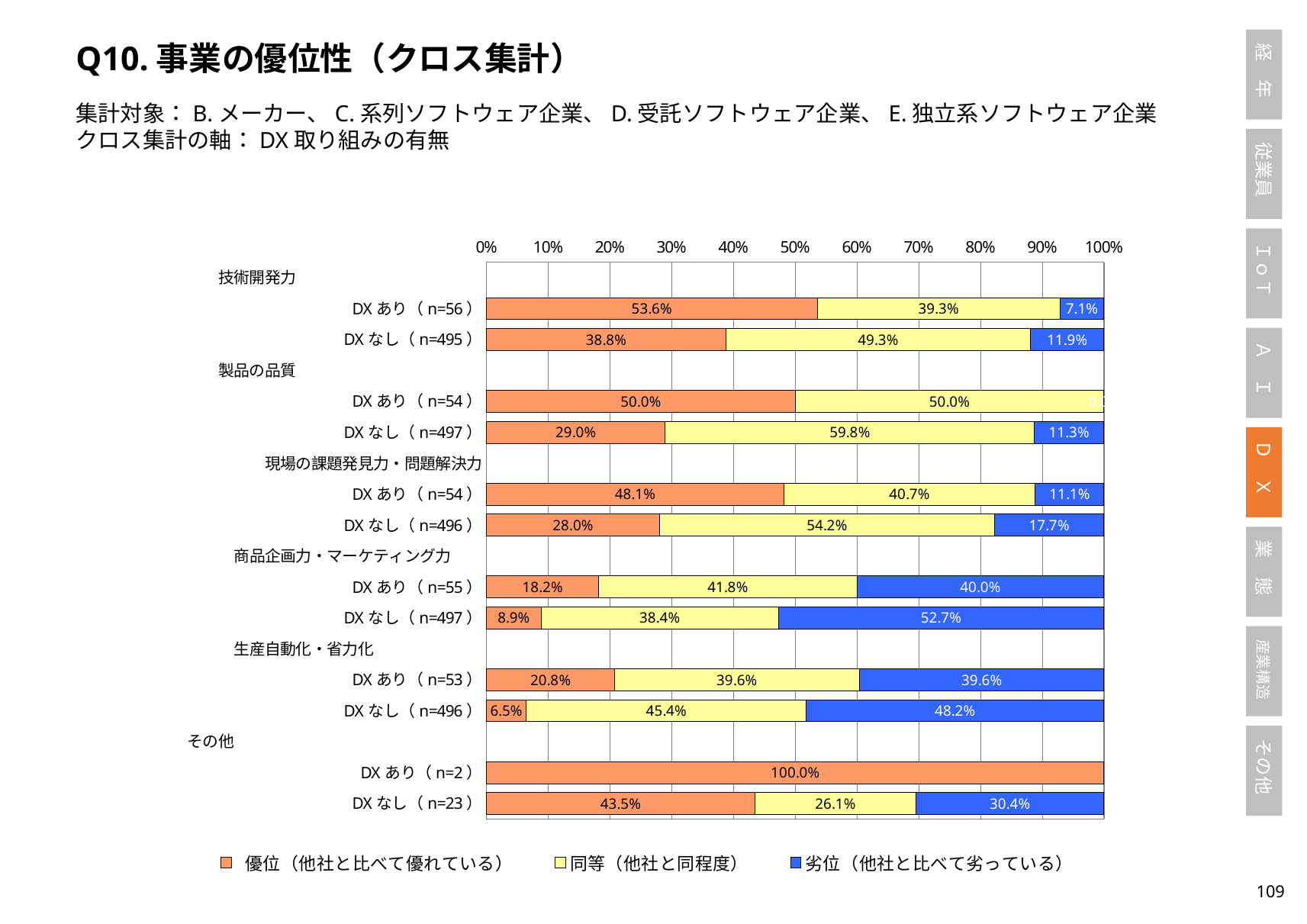
What is the 優位 share for 生産自動化・省力化, DX なし (n=496)? 6.5% What kind of chart is shown on the slide? Stacked horizontal bar chart What is the 劣位 (inferior) share for 商品企画力・マーケティング力, DX なし (n=497)? 52.7% What is the difference in the 優位 share between DX あり (n=56) and DX なし (n=495) for 技術開発力? 14.8% What is the 優位 (superior) share for 技術開発力, DX あり (n=56)? 53.6% What is the 同等 (equal) share for 製品の品質, DX なし (n=497)? 59.8% What colour represents 劣位 (他社と比べて劣っている) in the chart? Blue For 現場の課題発見力・問題解決力, which has the larger 劣位 share: DX あり (n=54) or DX なし (n=496)? DX なし (n=496) How many series does the legend list? 3 What is the total of the 優位 and 同等 shares for 商品企画力・マーケティング力, DX あり (n=55)? 60.0% Which row has the lowest 優位 (superior) share? 生産自動化・省力化 DX なし (n=496) Which row has the highest 優位 (superior) share? その他 DX あり (n=2)